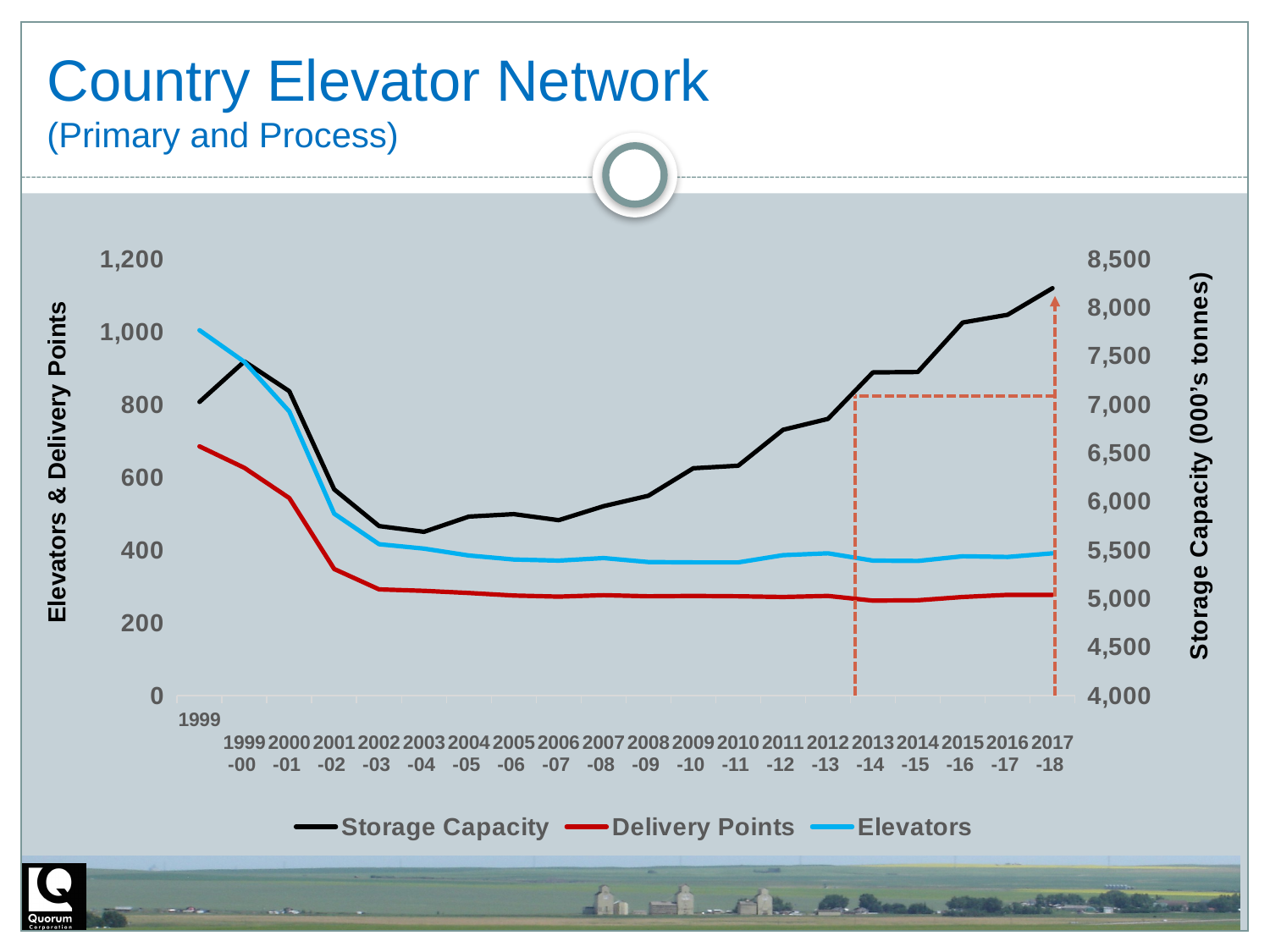
In which period is the number of Elevators at its highest? 1999 Is the value for Delivery Points in 2017-18 greater or less than 400? less How many series does the legend list? 3 What is the title of the right-hand vertical axis? Storage Capacity (000's tonnes) Does the Elevators line rise or fall from 1999-00 to 2017-18? fall Does the Storage Capacity line rise or fall from 2009-10 to 2017-18? rise Is the Storage Capacity value in 2003-04 greater or less than 6,000 on the right axis? less Is the value for Elevators in 1999-00 greater or less than 800? greater In which period is Storage Capacity at its highest? 2017-18 What kind of chart is shown on the slide? line chart How many crop-year periods are plotted along the x axis? 19